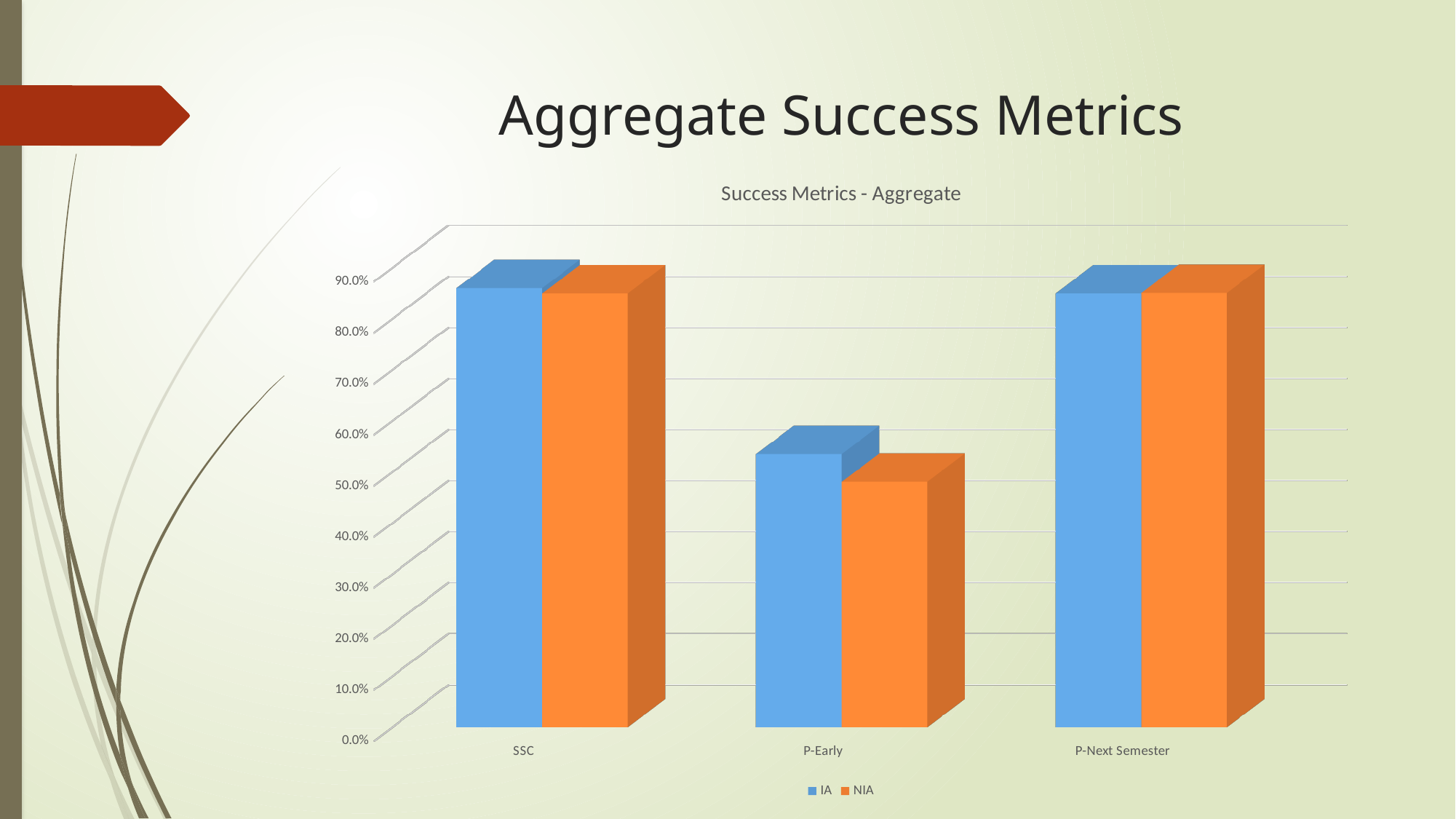
Is the NIA value for P-Early greater or less than 40.0%? greater What kind of chart is shown on the slide? bar chart Is the IA value for SSC greater or less than 80.0%? greater Which is larger, the IA value for SSC or the IA value for P-Early? SSC Which series is shown in orange in the chart? NIA How many series does the chart's legend list? 2 Which category has the lowest NIA value? P-Early Is the IA value for P-Early greater or less than 60.0%? less How many categories are shown on the x axis of the chart? 3 Which category has the lowest IA value? P-Early What is the title of the chart? Success Metrics - Aggregate